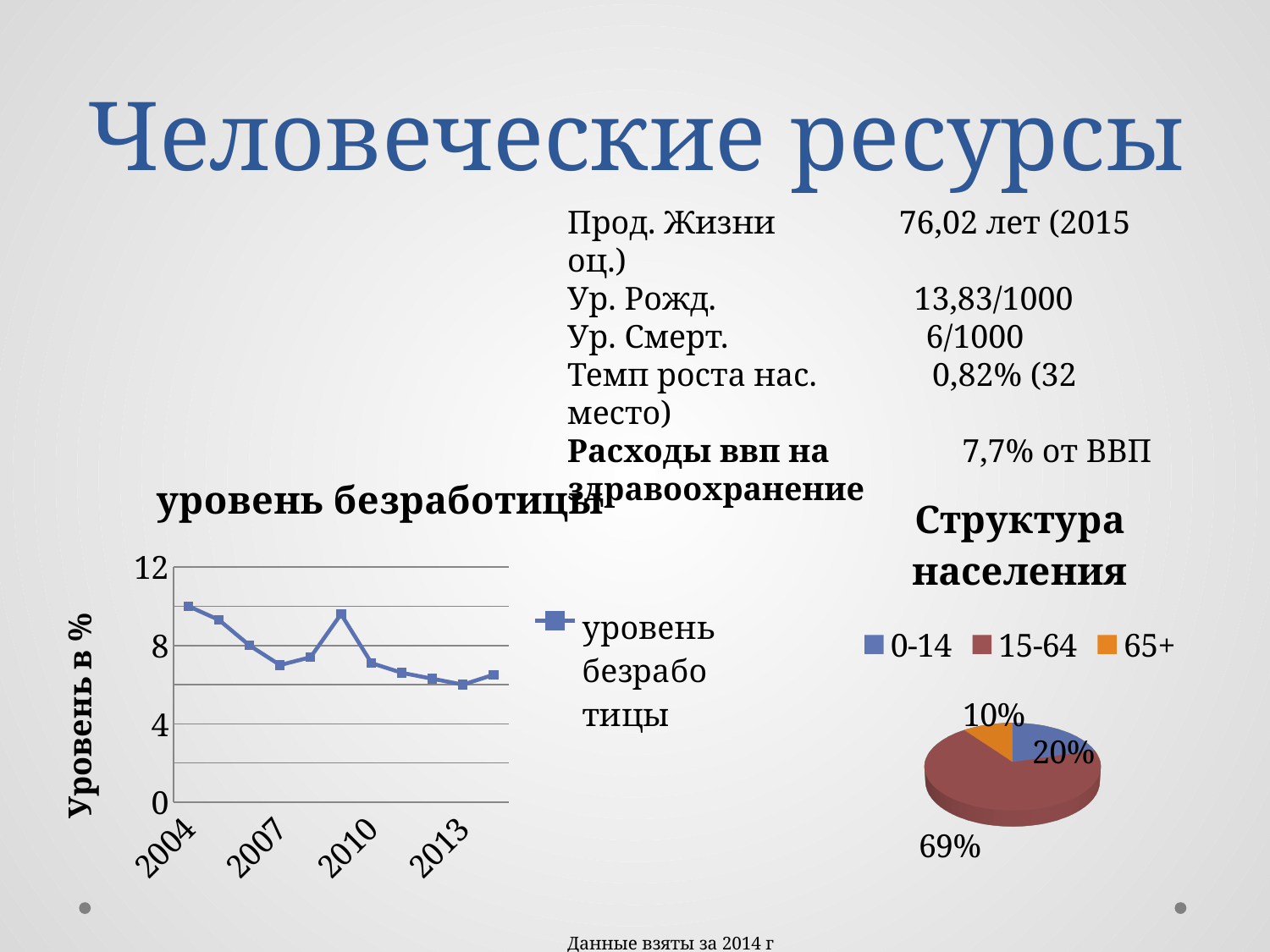
In the chart "уровень безработицы", does the unemployment rate overall rise or fall from 2004 to the last year shown? fall In the pie chart "Структура населения", what share does the 0-14 group have? 20% In the pie chart "Структура населения", which age group has the largest slice? 15-64 In the pie chart "Структура населения", what share does the 65+ group have? 10% In the pie chart "Структура населения", what share does the 15-64 group have? 69% In the pie chart "Структура населения", how many percentage points larger is the 15-64 share than the 0-14 share? 49 What is the y-axis title of the chart "уровень безработицы"? Уровень в % In the chart "уровень безработицы", is the value for 2004 greater or less than 8? greater In the chart "уровень безработицы", is the value for 2013 greater or less than 8? less In the pie chart "Структура населения", which age group has the smallest slice? 65+ How many entries does the legend of the pie chart "Структура населения" list? 3 What kind of chart is "уровень безработицы"? line chart